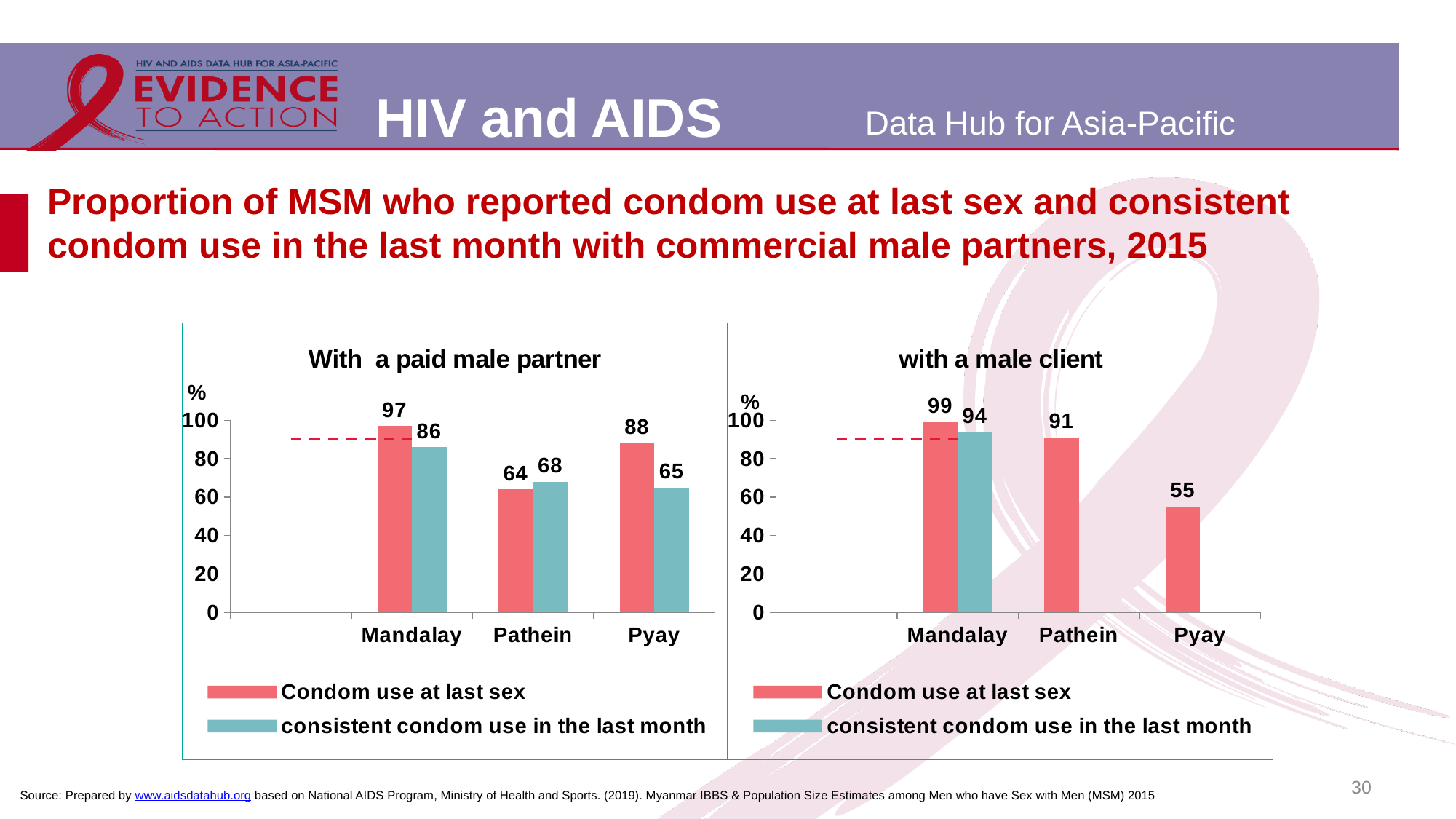
How many series does the legend of the 'With a paid male partner' chart list? 2 In the 'With a paid male partner' chart, which is larger in Pathein: condom use at last sex or consistent condom use in the last month? consistent condom use in the last month In the 'with a male client' chart, what is the difference in condom use at last sex between Pathein and Pyay? 36 In the 'With a paid male partner' chart, what is the difference between condom use at last sex and consistent condom use in the last month in Pyay? 23 In the 'With a paid male partner' chart, what is the value for consistent condom use in the last month in Pathein? 68 In the 'With a paid male partner' chart, what is the value for condom use at last sex in Mandalay? 97 In the 'with a male client' chart, which city has the highest value for condom use at last sex? Mandalay What type of chart is the 'with a male client' chart? bar chart In the 'With a paid male partner' chart, which city has the lowest value for condom use at last sex? Pathein In the 'with a male client' chart, what is the value for consistent condom use in the last month in Mandalay? 94 In the 'with a male client' chart, what is the value for condom use at last sex in Pyay? 55 How many cities are shown on the x axis of the 'with a male client' chart? 3